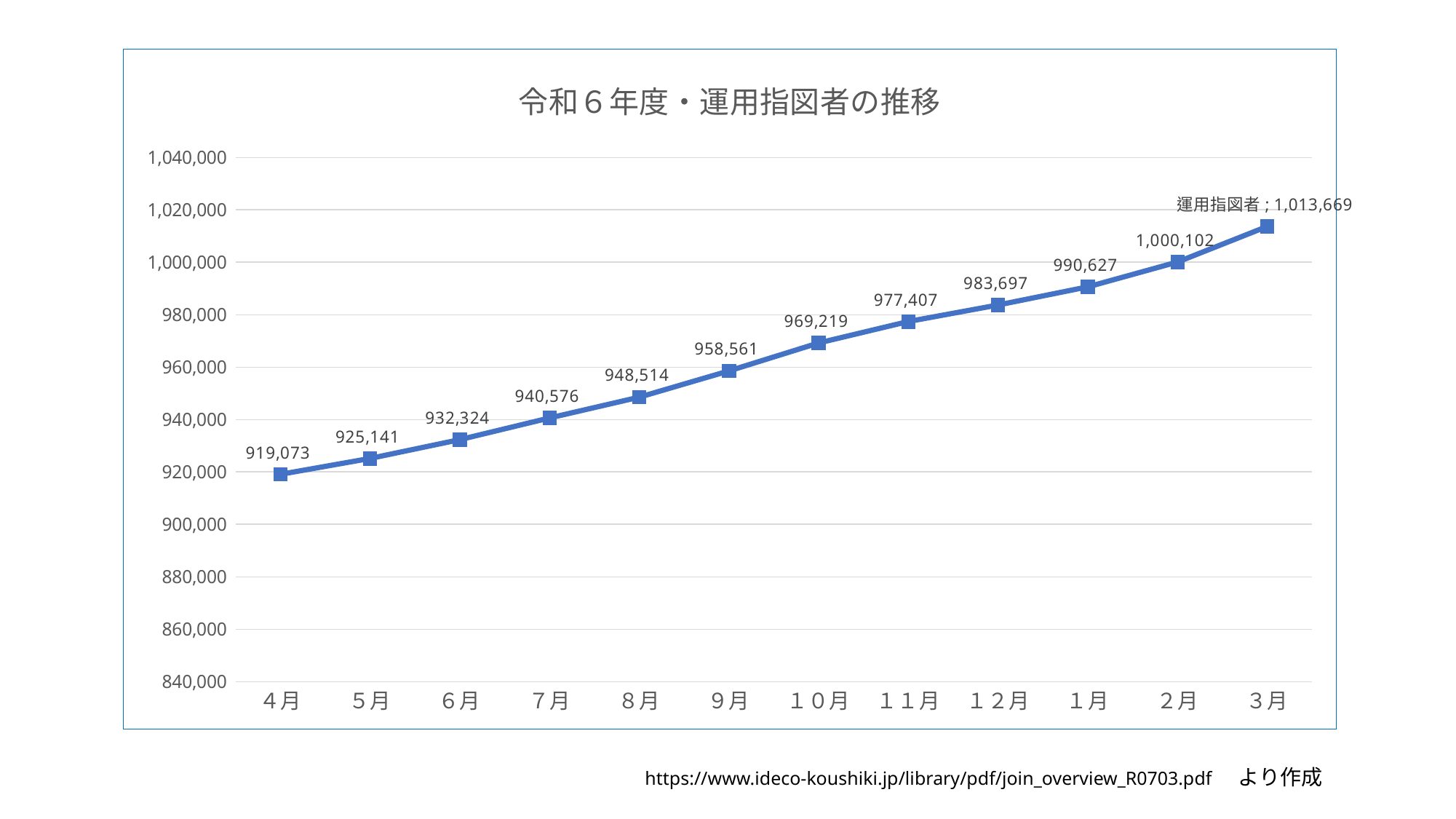
Which is larger, the value for 7月 or the value for 10月? 10月 What is the value for 12月? 983,697 Which month has the lowest value? 4月 What is the difference between the values for 3月 and 4月? 94,596 What is the value for 4月? 919,073 What is the value for 9月? 958,561 What is the difference between the values for 2月 and 1月? 9,475 What is the value for 2月? 1,000,102 Which month has the highest value? 3月 Do the values rise or fall from 4月 to 3月? rise How many data points are plotted on the chart? 12 What type of chart is shown on the slide? line chart